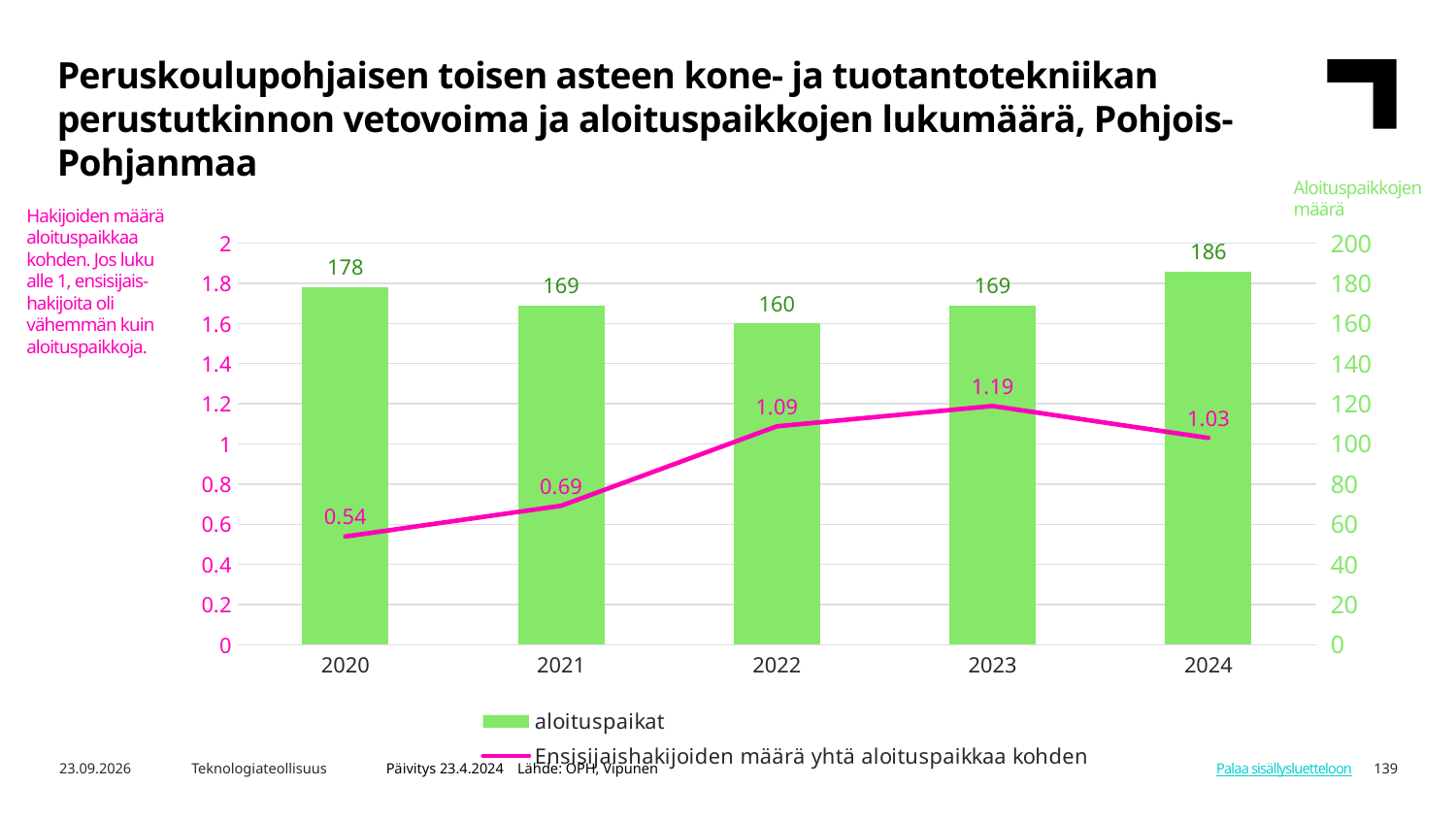
What is the value of aloituspaikat for 2020? 178 Does the Ensisijaishakijoiden määrä yhtä aloituspaikkaa kohden line rise or fall from 2020 to 2023? rise What is the value of Ensisijaishakijoiden määrä yhtä aloituspaikkaa kohden for 2023? 1.19 What kind of chart is used to show the aloituspaikat series? bar chart Is the value of Ensisijaishakijoiden määrä yhtä aloituspaikkaa kohden larger in 2022 or in 2024? 2022 Which year has the highest value of aloituspaikat? 2024 Is the aloituspaikat value for 2022 greater or less than 180? less What is the difference between the aloituspaikat values for 2024 and 2022? 26 Which year has the lowest value of Ensisijaishakijoiden määrä yhtä aloituspaikkaa kohden? 2020 How many series does the legend list? 2 How many years are shown on the x axis? 5 What is the value of aloituspaikat for 2024? 186